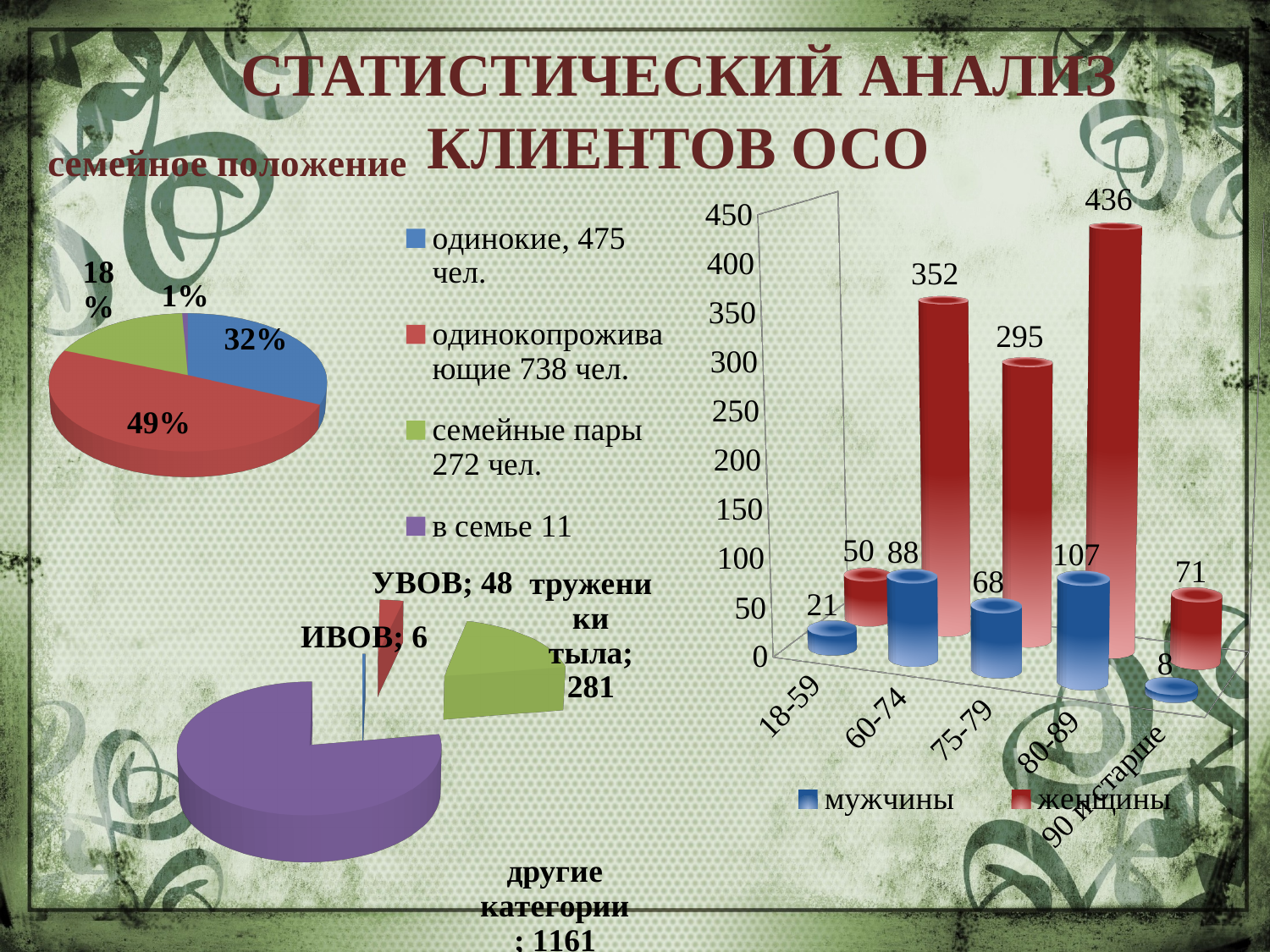
In the pie chart titled 'семейное положение', what share of the pie is одинокопроживающие? 49% In the pie chart titled 'семейное положение', how many people are in the category семейные пары? 272 чел. In the bar chart on the right, what is the difference between женщины and мужчины in the 75-79 age group? 227 In the bar chart on the right, what is the value for женщины in the 80-89 age group? 436 In the bar chart on the right, what is the value for мужчины in the 60-74 age group? 88 In the bar chart on the right, which age group has the highest value for женщины? 80-89 In the bar chart on the right, how many series does the legend list? 2 What kind of chart is the chart on the right of the slide? bar chart In the bottom-left pie chart, what is the value for труженики тыла? 281 In the bar chart on the right, which is larger in the 18-59 age group: мужчины or женщины? женщины In the bar chart on the right, how many age groups are shown on the x axis? 5 In the bar chart on the right, which age group has the lowest value for мужчины? 90 и старше